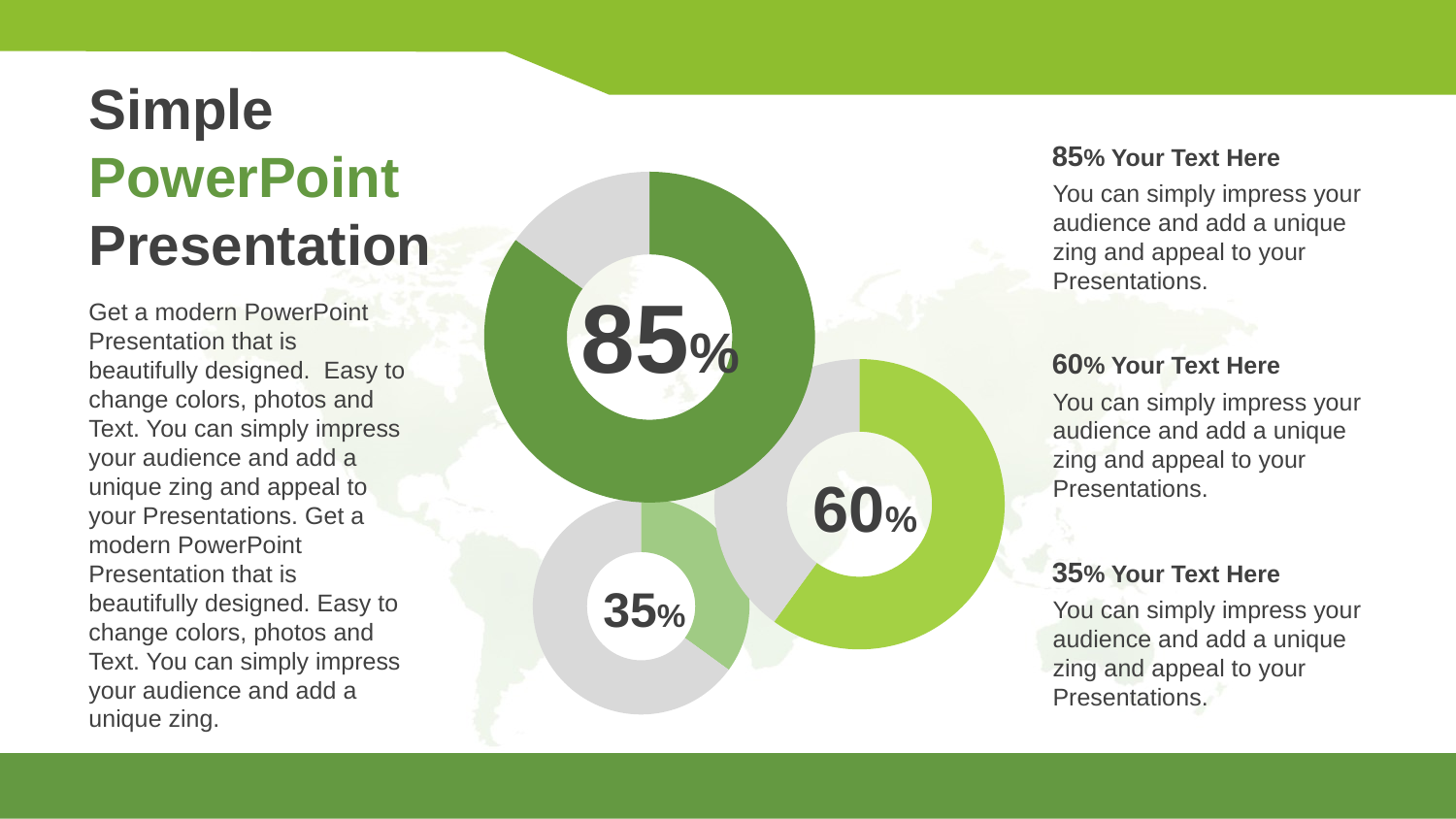
How many donut charts are shown on the slide? 3 What value is printed in the centre of the donut chart on the right? 60% What value is printed in the centre of the bottom-left donut chart? 35% What is the difference between the value in the largest donut chart (85%) and the bottom-left donut chart (35%)? 50% What value is printed in the centre of the largest donut chart at the top of the slide? 85% What kind of chart is used to display the 85%, 60% and 35% values? Donut (pie) chart Which of the three donut charts shows the highest value? 85% What is the difference between the value in the largest donut chart (85%) and the right donut chart (60%)? 25% What colour is the filled portion of the largest donut chart showing 85%? Dark green What is the difference between the value in the right donut chart (60%) and the bottom-left donut chart (35%)? 25% Which is larger, the value in the right donut chart or the value in the bottom-left donut chart? The right donut chart (60%) Which of the three donut charts shows the lowest value? 35%